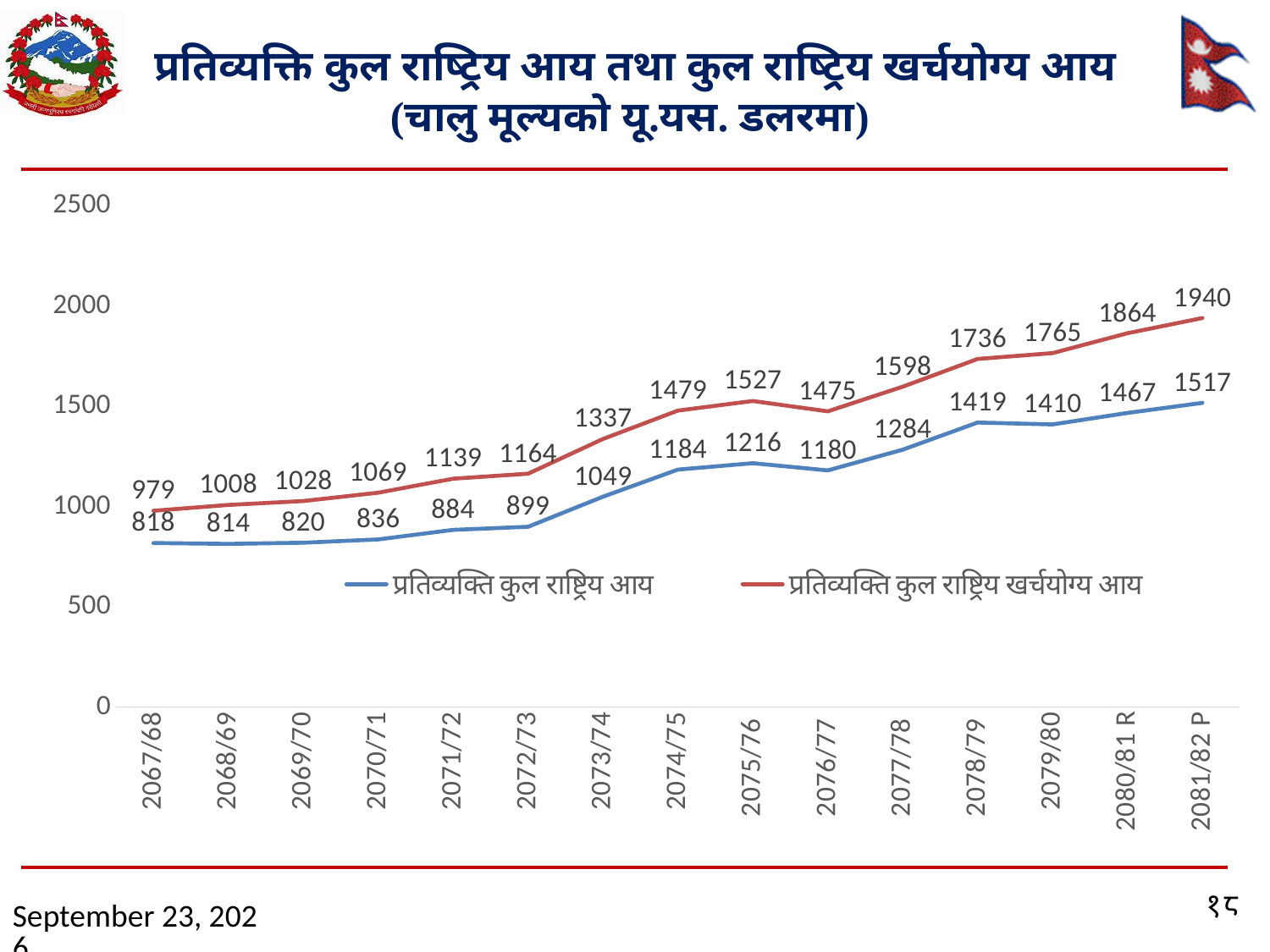
Is the value of प्रतिव्यक्ति कुल राष्ट्रिय खर्चयोग्य आय for 2080/81 R greater or less than 2000? less In which year is प्रतिव्यक्ति कुल राष्ट्रिय खर्चयोग्य आय highest? 2081/82 P What is the value of प्रतिव्यक्ति कुल राष्ट्रिय खर्चयोग्य आय for 2067/68? 979 What is the value of प्रतिव्यक्ति कुल राष्ट्रिय आय for 2081/82 P? 1517 How many years are shown on the x axis? 15 Which is larger for 2076/77: प्रतिव्यक्ति कुल राष्ट्रिय आय or प्रतिव्यक्ति कुल राष्ट्रिय खर्चयोग्य आय? प्रतिव्यक्ति कुल राष्ट्रिय खर्चयोग्य आय In which year is प्रतिव्यक्ति कुल राष्ट्रिय आय lowest? 2068/69 What kind of chart is shown on the slide? line chart What is the difference between प्रतिव्यक्ति कुल राष्ट्रिय खर्चयोग्य आय and प्रतिव्यक्ति कुल राष्ट्रिय आय in 2081/82 P? 423 How many series does the legend list? 2 What is the value of प्रतिव्यक्ति कुल राष्ट्रिय खर्चयोग्य आय for 2075/76? 1527 Does प्रतिव्यक्ति कुल राष्ट्रिय खर्चयोग्य आय rise or fall from 2077/78 to 2081/82 P? rise